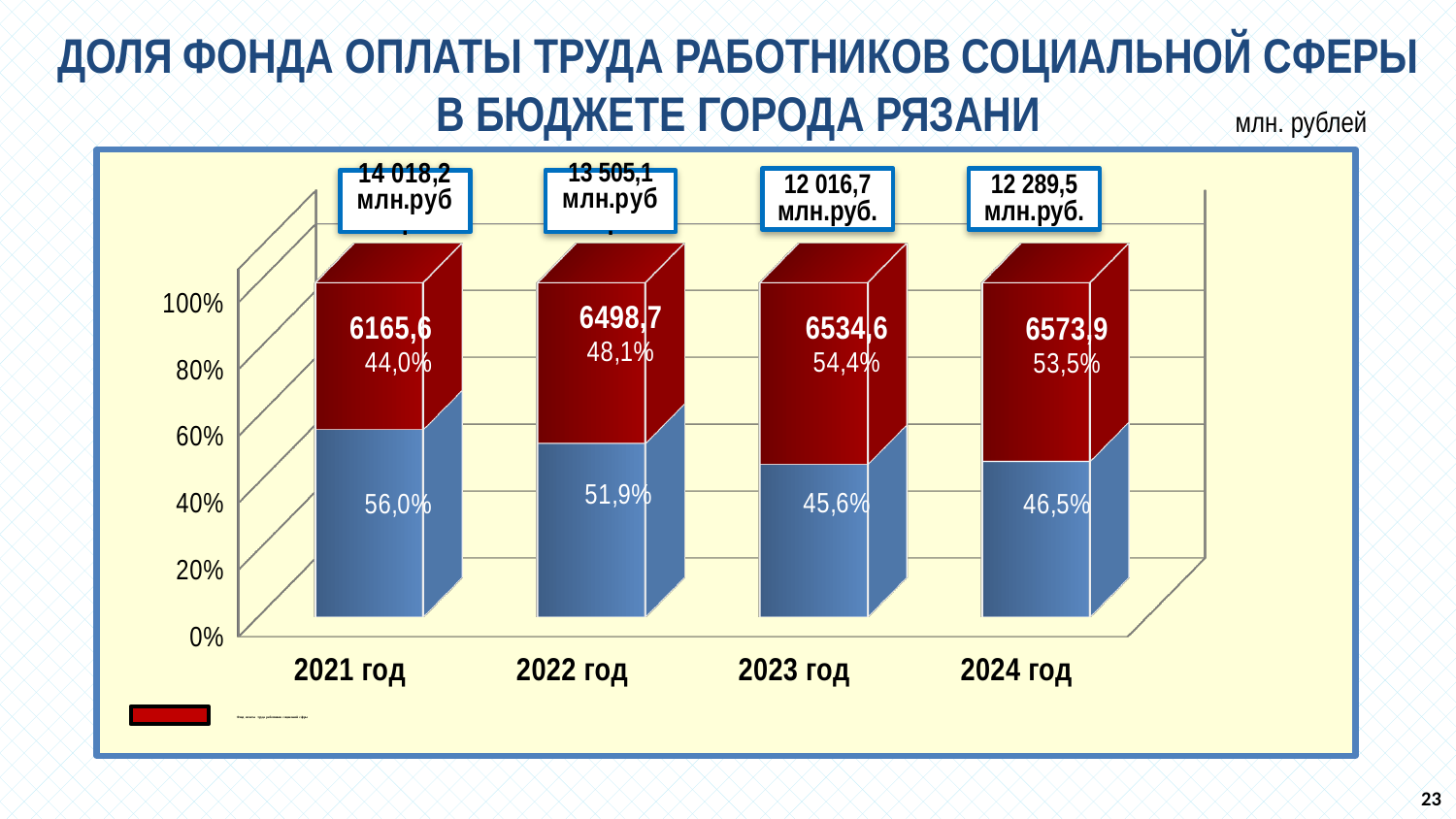
What is the difference between the red-segment values for 2024 год (6573,9) and 2021 год (6165,6)? 408,3 What unit is indicated at the top right of the chart? млн. рублей In which year is the percentage on the red segment the highest? 2023 год Does the percentage on the red segment rise or fall from 2021 год to 2023 год? Rise Which year has the larger red-segment percentage, 2022 год or 2023 год? 2023 год What kind of chart is shown on the slide? Stacked bar chart What percentage is printed on the blue segment for 2023 год? 45,6% What percentage is printed on the red segment for 2021 год? 44,0% How many years are shown on the x axis of the chart? 4 What total value is printed in the box above the bar for 2022 год? 13 505,1 млн.руб What value in млн.руб is printed on the red segment for 2024 год? 6573,9 In which year is the percentage on the red segment the lowest? 2021 год